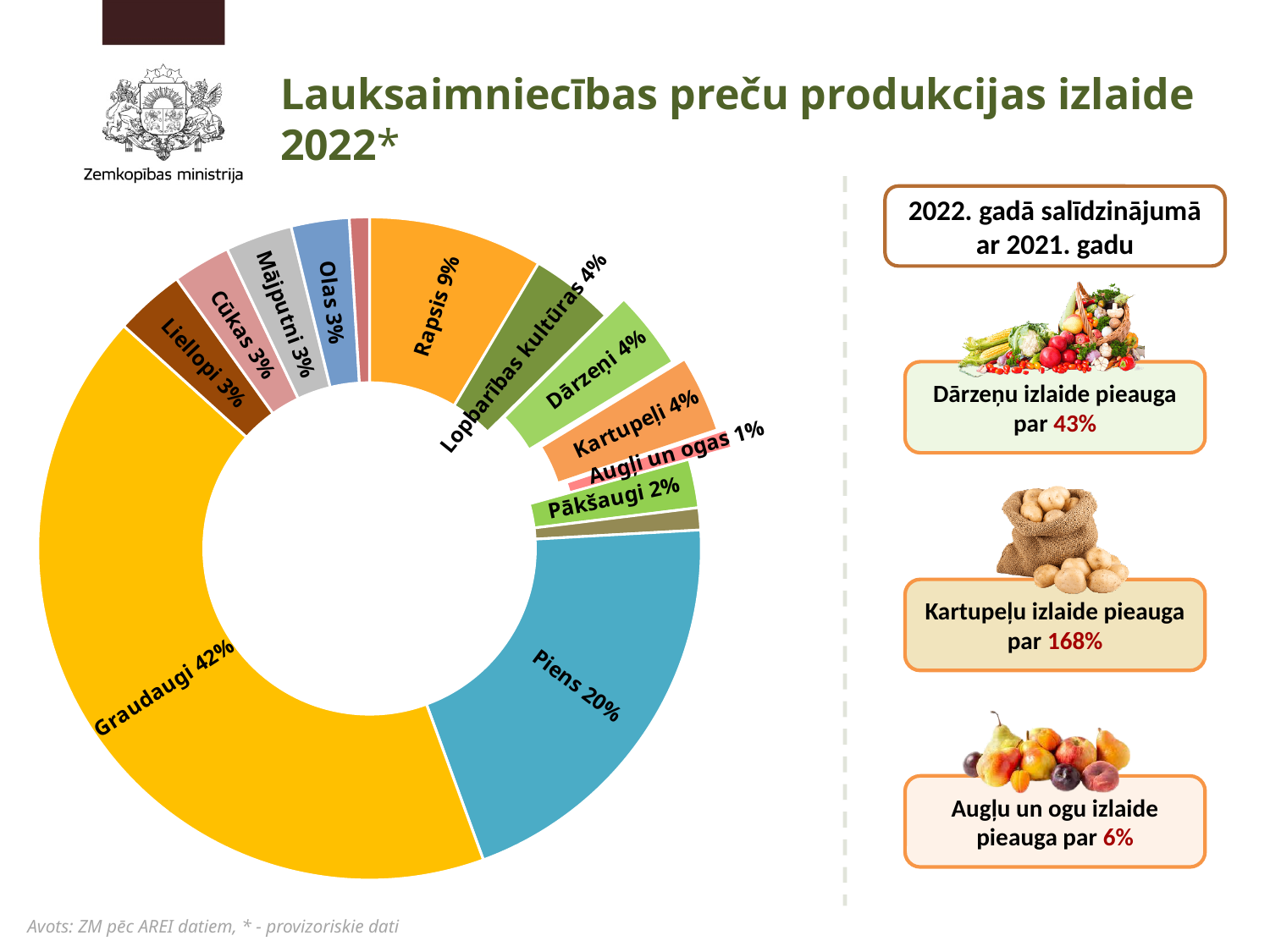
What kind of chart is shown on the slide? doughnut chart What share of the chart does Augļi un ogas have? 1% What share of the chart does Piens have? 20% What share of the chart does Graudaugi have? 42% What is the combined share of Dārzeņi and Kartupeļi? 8% What share of the chart does Pākšaugi have? 2% How many percentage points larger is the share of Graudaugi than the share of Piens? 22 What is the title of the slide containing the chart? Lauksaimniecības preču produkcijas izlaide 2022* Which has the larger share, Pākšaugi or Kartupeļi? Kartupeļi What share of the chart does Rapsis have? 9% Which has the larger share, Rapsis or Piens? Piens Which category has the largest share of the chart? Graudaugi